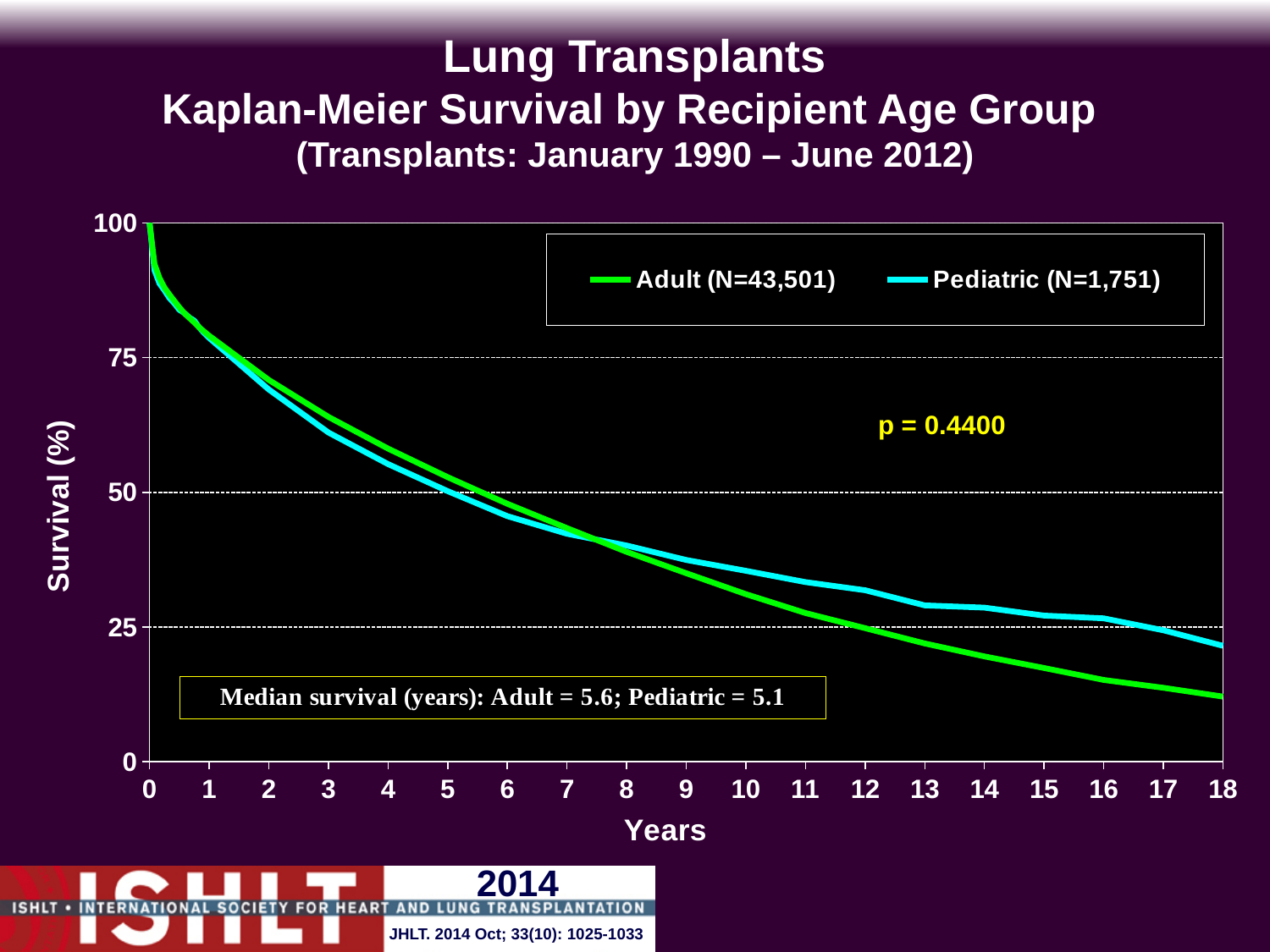
What p-value is printed on the chart? p = 0.4400 Is the Pediatric survival value at 12 years greater or less than 25? greater What kind of chart is shown on the slide? line chart How many series does the legend list? 2 What is the N for the Pediatric group shown in the legend? 1,751 Do the survival curves rise or fall as years increase? fall What is the median survival in years for Adult recipients? 5.6 What is the median survival in years for Pediatric recipients? 5.1 What is the difference in median survival (years) between Adult and Pediatric recipients? 0.5 What is the N for the Adult group shown in the legend? 43,501 Is the Adult survival value at 18 years greater or less than 25? less At 15 years, which group has the higher survival, Adult or Pediatric? Pediatric